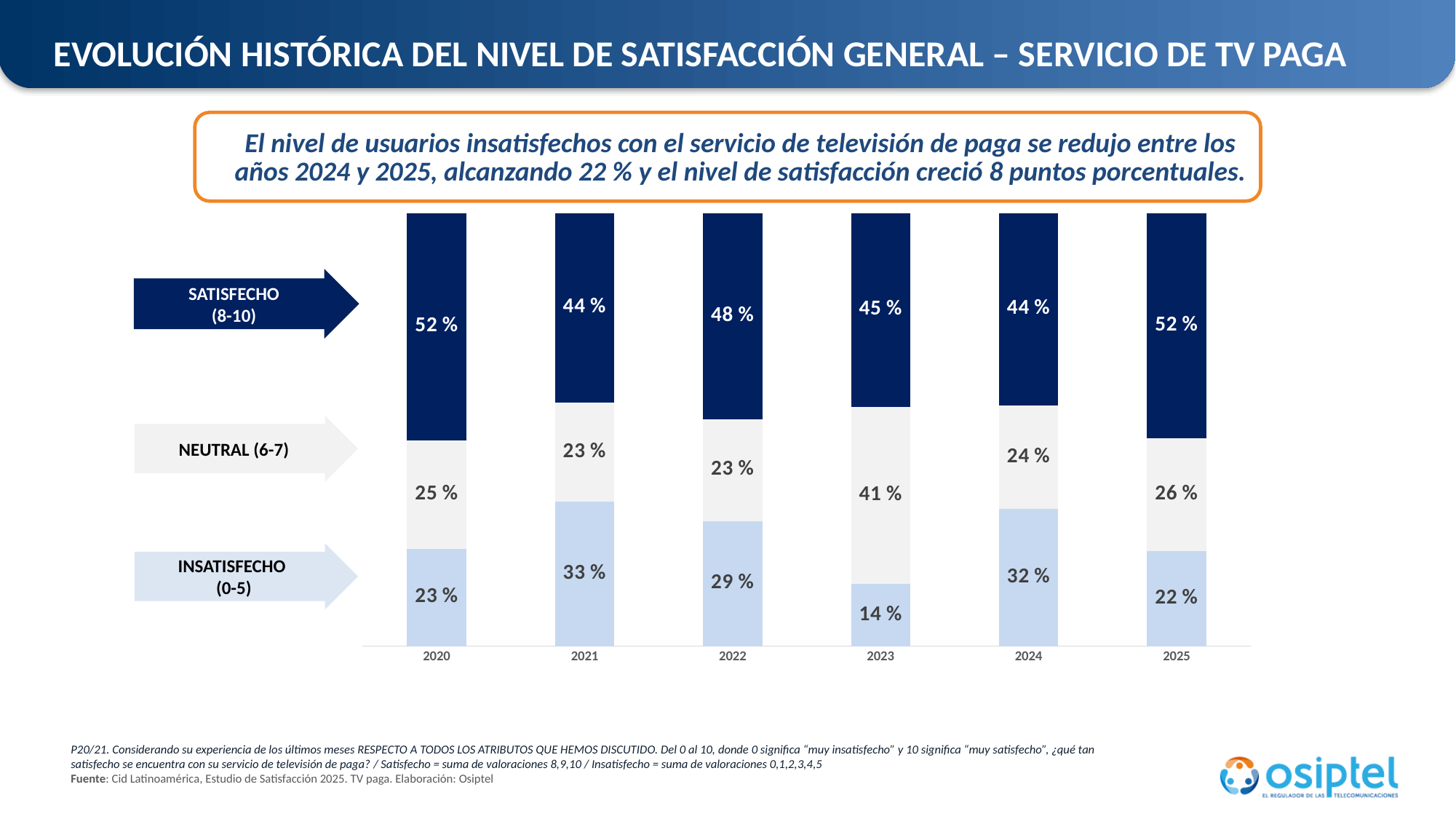
What is the Insatisfecho (0-5) value for 2023? 14 % What is the difference between the Insatisfecho (0-5) values for 2024 and 2025? 10 percentage points How many series does the chart show? 3 In which year is the Insatisfecho (0-5) value highest? 2021 What kind of chart is shown on the slide? Stacked bar chart How many years are shown on the x axis? 6 Which is larger, the Satisfecho (8-10) value for 2022 or for 2023? 2022 What is the Neutral (6-7) value for 2024? 24 % What is the total of the stacked bar for 2021? 100 % What is the Satisfecho (8-10) value for 2025? 52 % In which year is the Insatisfecho (0-5) value lowest? 2023 In which year is the Neutral (6-7) value highest? 2023